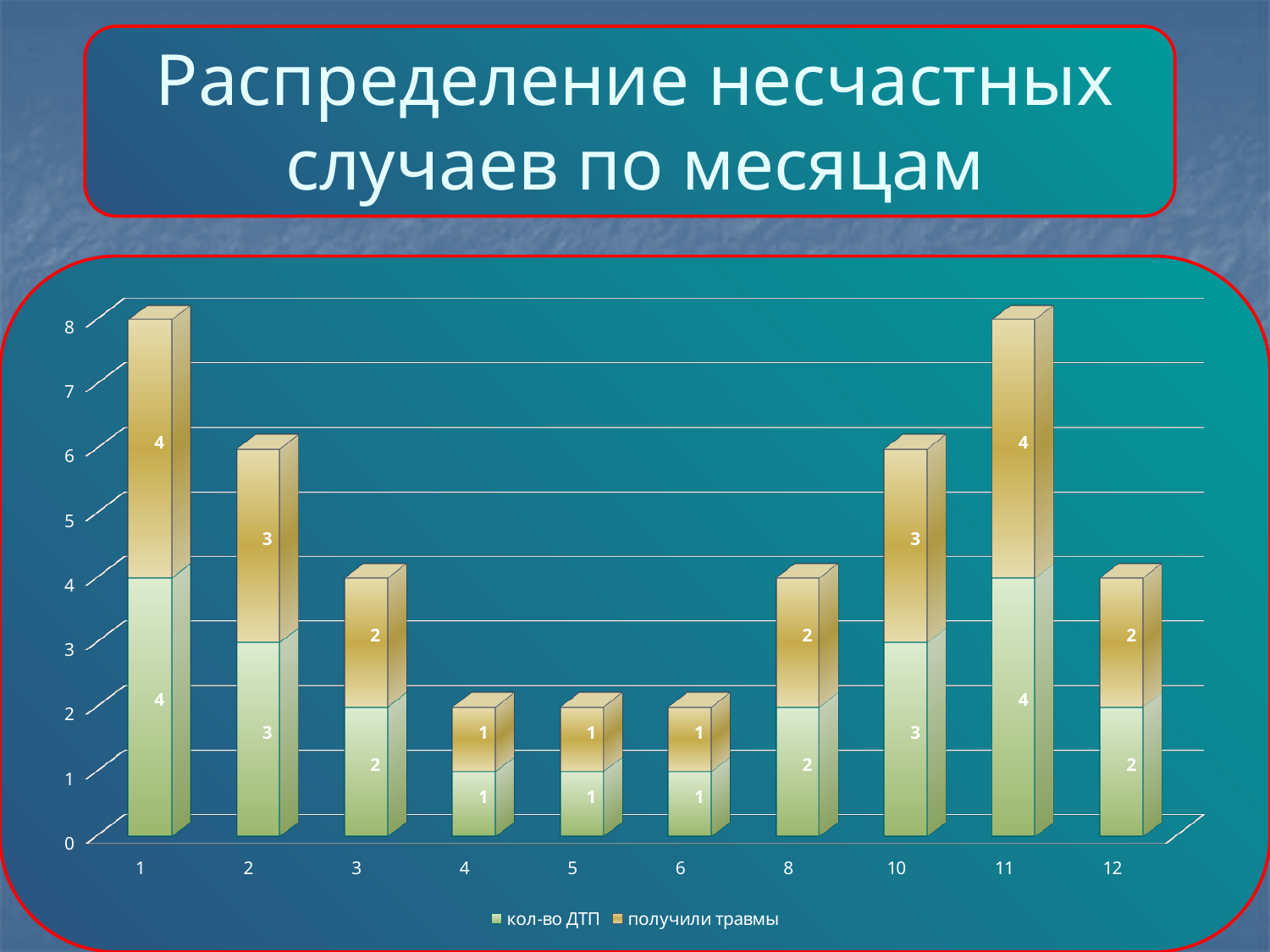
What is the total of the stacked bar for category 2? 6 What kind of chart is shown on the slide? stacked bar chart What is the value of "получили травмы" for category 5? 1 How many series does the legend list? 2 What is the value of "получили травмы" for category 10? 3 What is the total of the stacked bar for category 11? 8 Which has a larger "получили травмы" value, category 2 or category 8? category 2 How many categories are shown on the x axis? 10 What is the title of the slide? Распределение несчастных случаев по месяцам What is the value of "кол-во ДТП" for category 12? 2 What is the difference between the "кол-во ДТП" values for category 1 and category 3? 2 What is the value of "кол-во ДТП" for category 1? 4